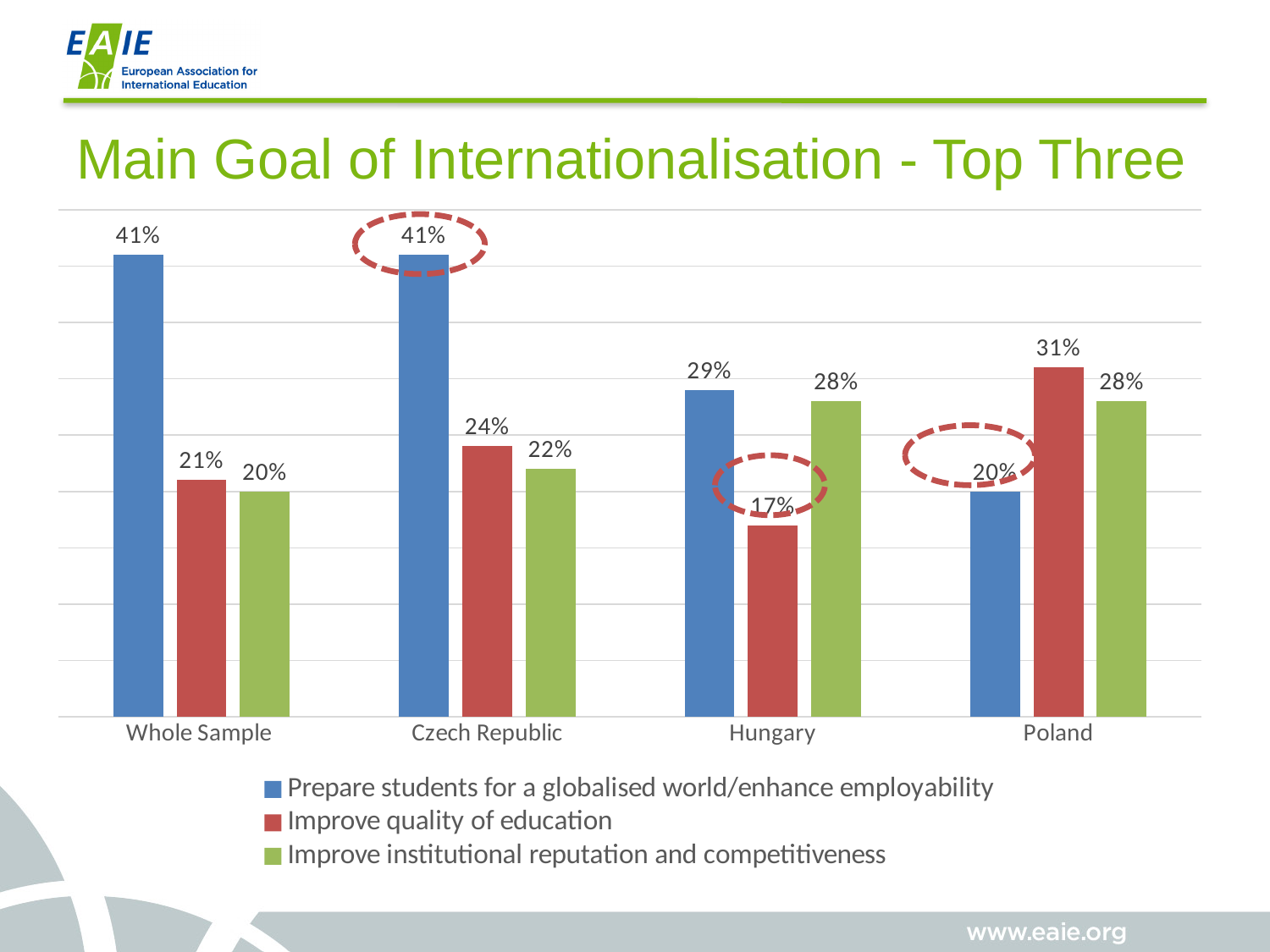
What is the value for 'Prepare students for a globalised world/enhance employability' in the Czech Republic? 41% What kind of chart is shown on the slide? Bar chart What is the difference between 'Prepare students for a globalised world/enhance employability' and 'Improve quality of education' in the Czech Republic? 17% What is the value for 'Improve quality of education' in Hungary? 17% Which category has the highest value for 'Improve quality of education'? Poland What is the value for 'Improve institutional reputation and competitiveness' in Poland? 28% How many categories are shown on the x axis? 4 What is the value for 'Improve quality of education' in the Whole Sample? 21% In Poland, which is larger: 'Improve quality of education' or 'Prepare students for a globalised world/enhance employability'? Improve quality of education How many series does the legend list? 3 What is the title of the chart? Main Goal of Internationalisation - Top Three Which category has the lowest value for 'Prepare students for a globalised world/enhance employability'? Poland